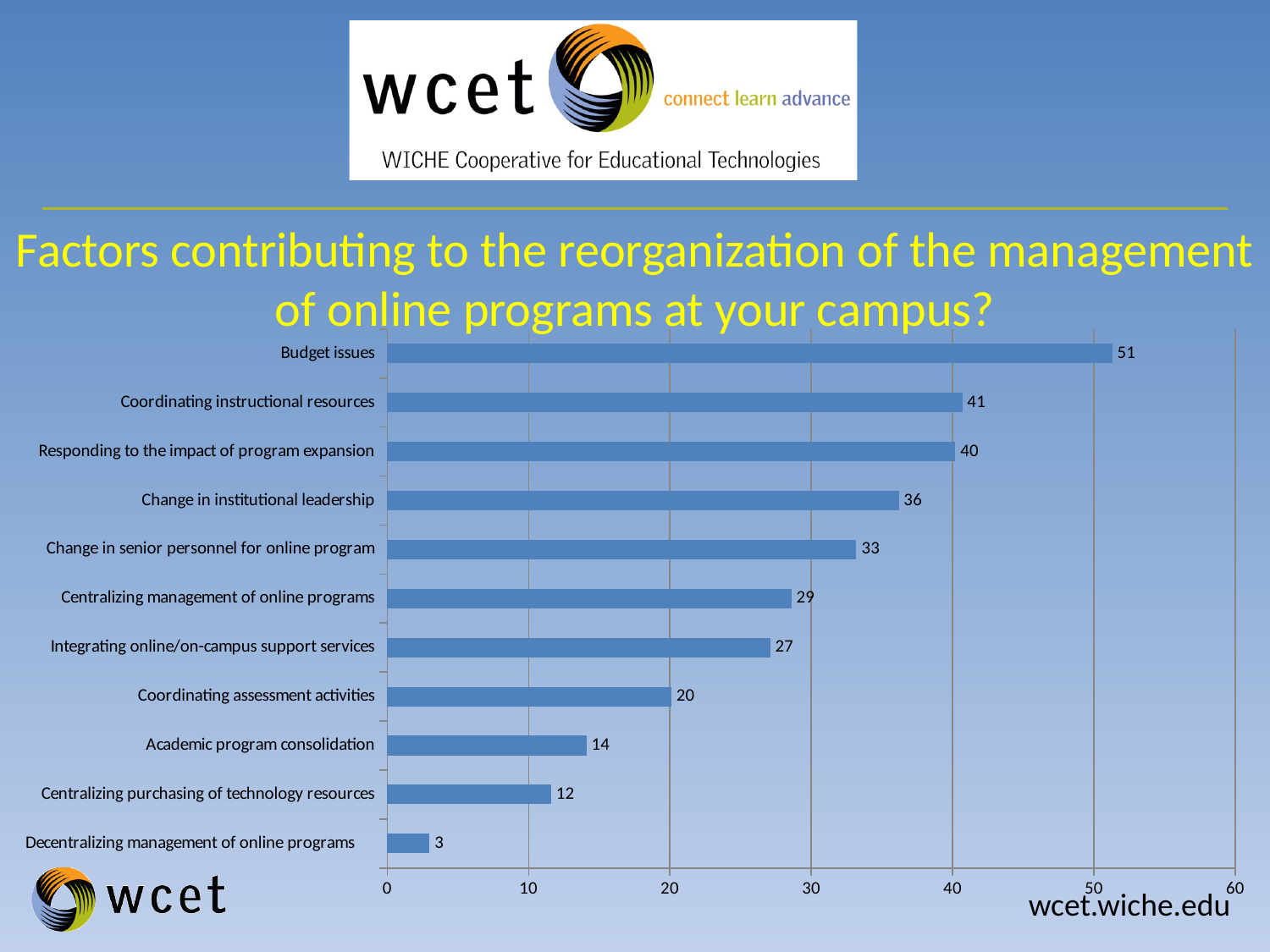
Is the value for Integrating online/on-campus support services greater or less than 30? less What is the value for Academic program consolidation? 14 What is the difference between the values for Budget issues and Coordinating instructional resources? 10 What is the value for Change in institutional leadership? 36 Which is larger, the value for Change in senior personnel for online program or the value for Centralizing management of online programs? Change in senior personnel for online program What is the difference between the values for Coordinating assessment activities and Centralizing purchasing of technology resources? 8 Which category has the highest value? Budget issues How many categories are shown in the chart? 11 What is the title of the chart? Factors contributing to the reorganization of the management of online programs at your campus? What is the value for Budget issues? 51 What kind of chart is shown on the slide? bar chart Which category has the lowest value? Decentralizing management of online programs